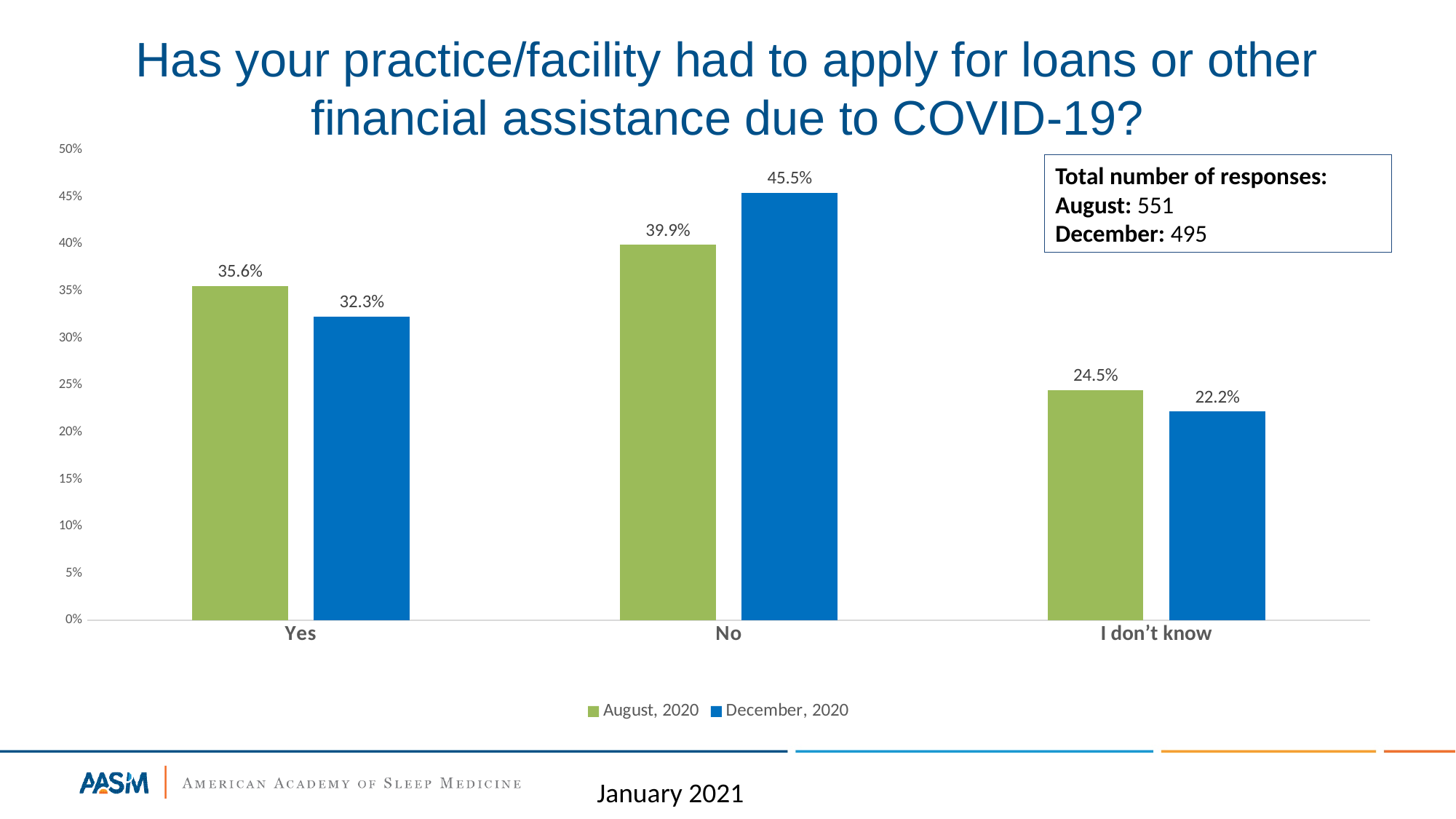
How many response categories are shown on the x axis? 3 Which is larger for "I don't know": the August, 2020 value or the December, 2020 value? August, 2020 What is the value for "I don't know" in the December, 2020 series? 22.2% What is the difference between the August, 2020 and December, 2020 values for "Yes"? 3.3% How many series does the legend list? 2 What is the difference between the December, 2020 and August, 2020 values for "No"? 5.6% Which response category has the lowest value in the August, 2020 series? I don't know What percentage of respondents answered "Yes" in August, 2020? 35.6% Which response category has the highest value in the December, 2020 series? No What kind of chart is shown on the slide? Bar chart What percentage of respondents answered "No" in December, 2020? 45.5% Is the value for "No" in August, 2020 greater or less than 35%? greater